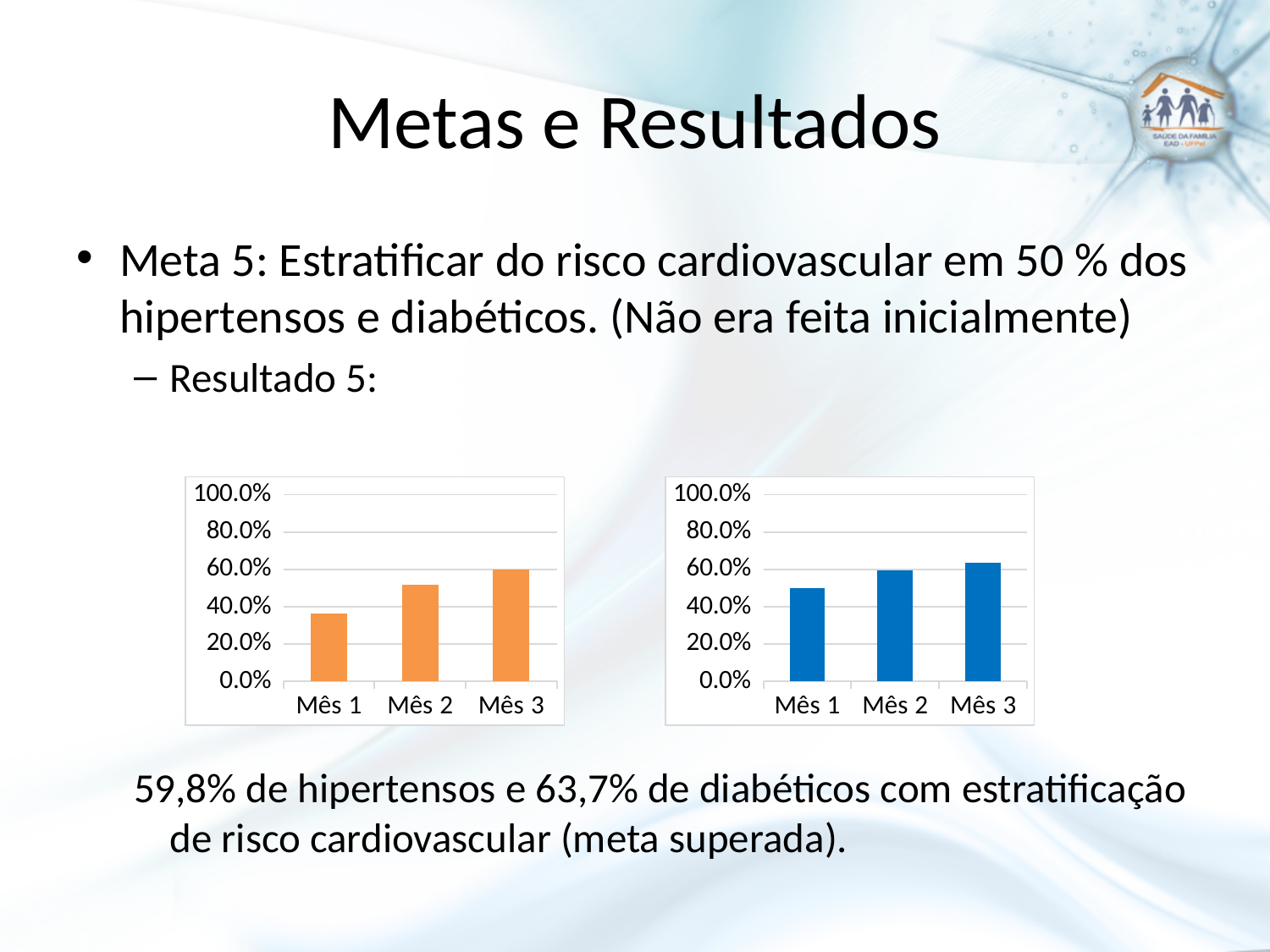
How many charts are on the slide? 2 In the left chart, do the values rise or fall from Mês 1 to Mês 3? rise In the left chart, which month has the highest value? Mês 3 In the left chart, what kind of chart is shown? bar chart In the right chart, which month has the highest value? Mês 3 In the right chart, which month has the lowest value? Mês 1 In the left chart, which month has the lowest value? Mês 1 In the left chart, which is larger, the value for Mês 1 or the value for Mês 3? Mês 3 In the right chart, is the value for Mês 1 greater or less than 80.0%? less In the right chart, how many categories are on the x axis? 3 In the left chart, is the value for Mês 1 greater or less than 40.0%? less In the right chart, is the value for Mês 3 greater or less than 40.0%? greater